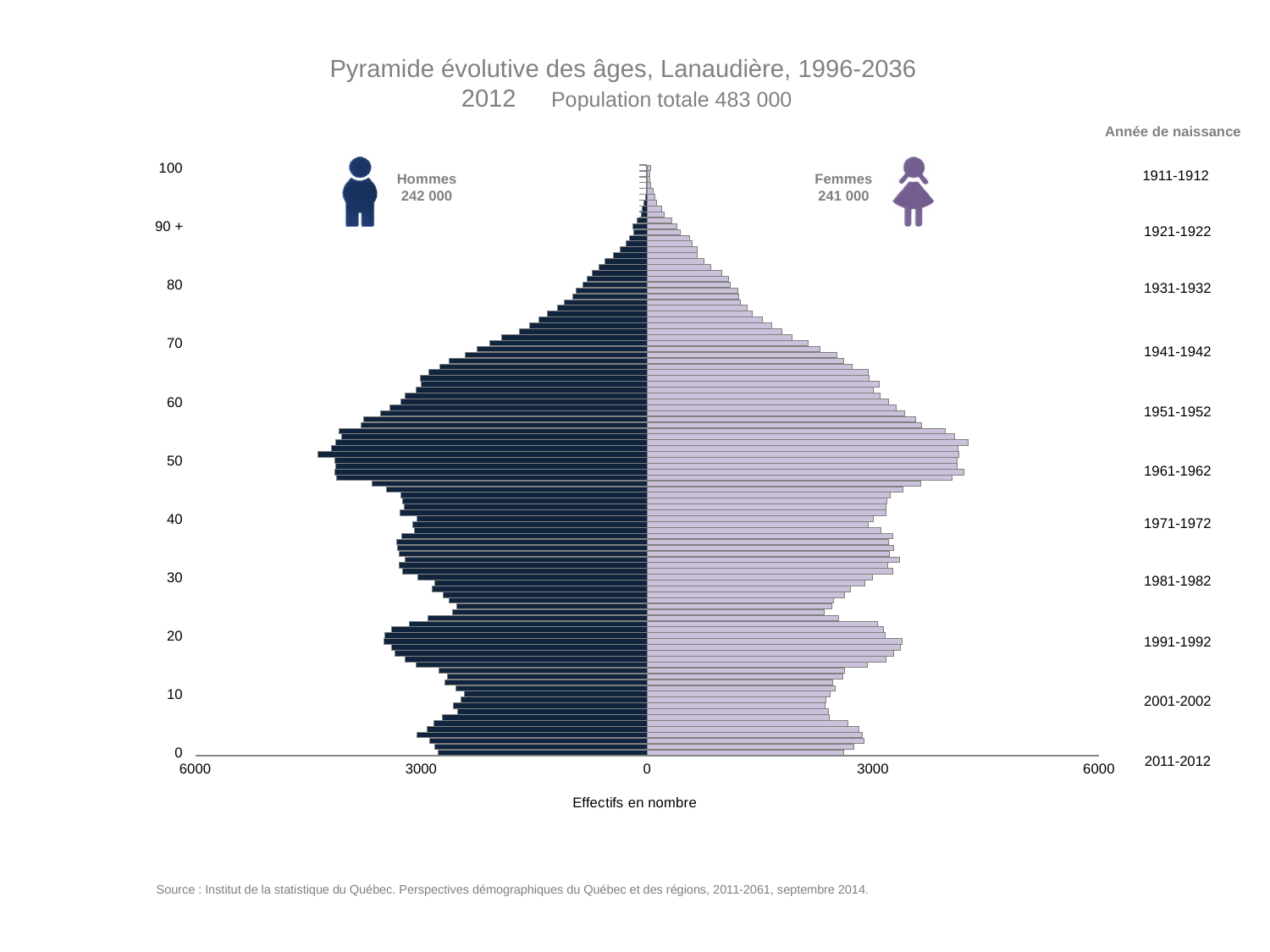
What is the Population totale shown for 2012? 483 000 What is the total number of Hommes shown on the chart? 242 000 Is the number of men aged 10 greater or less than 3000? less Is the number of women aged 80 greater or less than 3000? less Which group has the larger total, Hommes or Femmes? Hommes What year does the pyramid on this slide represent? 2012 What is the total number of Femmes shown on the chart? 241 000 Is the number of men aged 50 greater or less than 3000? greater What is the label of the horizontal axis? Effectifs en nombre What kind of chart is shown on the slide? Bar chart (population pyramid) What is the difference between the Hommes total and the Femmes total? 1 000